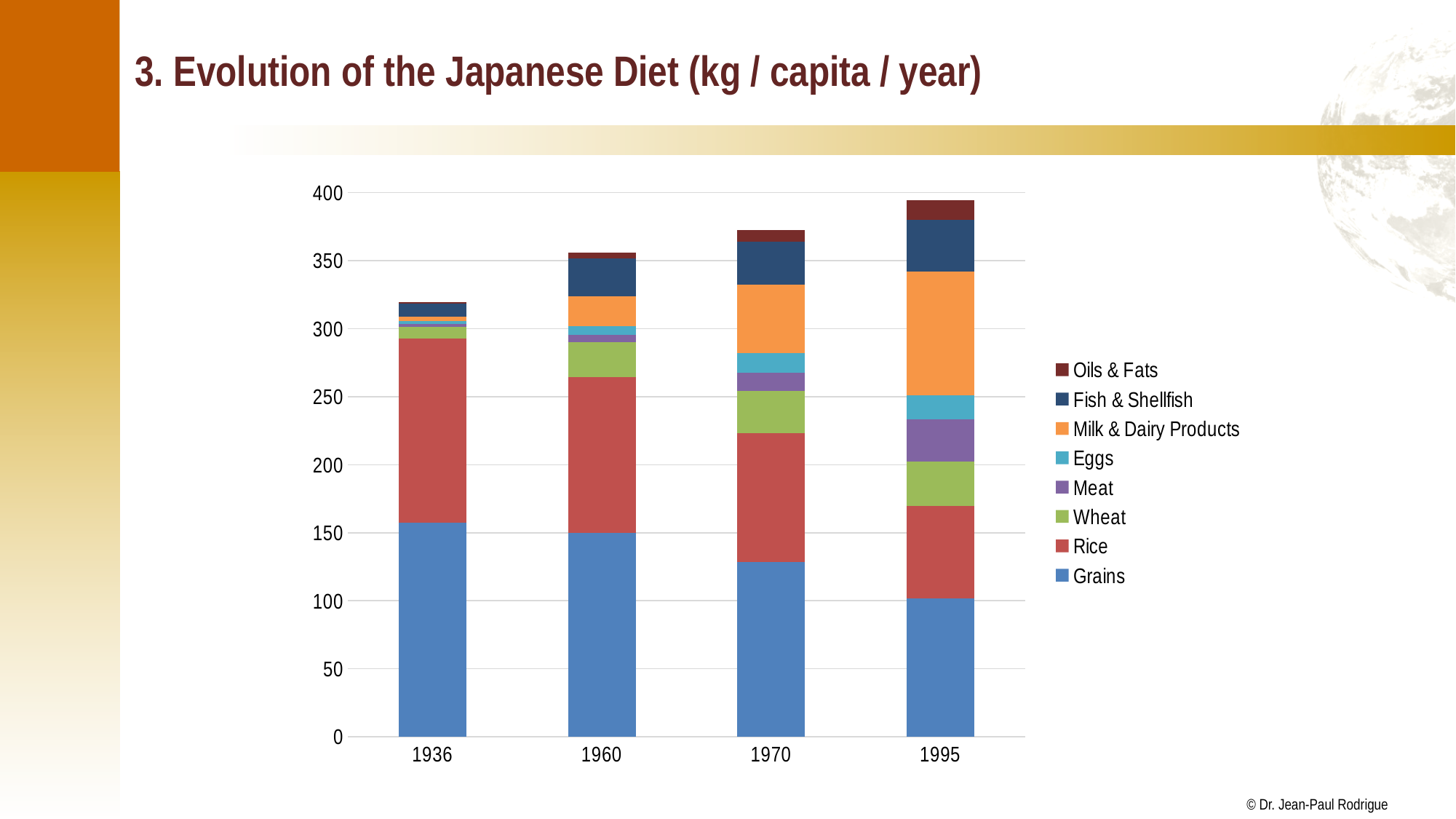
Is the total height of the 1936 bar greater or less than 350? less Which series is listed at the top of the legend? Oils & Fats How many years are shown on the x axis of the chart? 4 Which year has the shortest stacked bar overall? 1936 What kind of chart is shown on the slide? stacked bar chart Is the total height of the 1995 bar greater or less than 350? greater Which is larger, the Grains value for 1936 or the Grains value for 1995? 1936 Is the Grains value for 1936 greater or less than 100? greater Do the total heights of the stacked bars rise or fall from 1936 to 1995? rise Which year has the tallest stacked bar overall? 1995 How many series does the legend list? 8